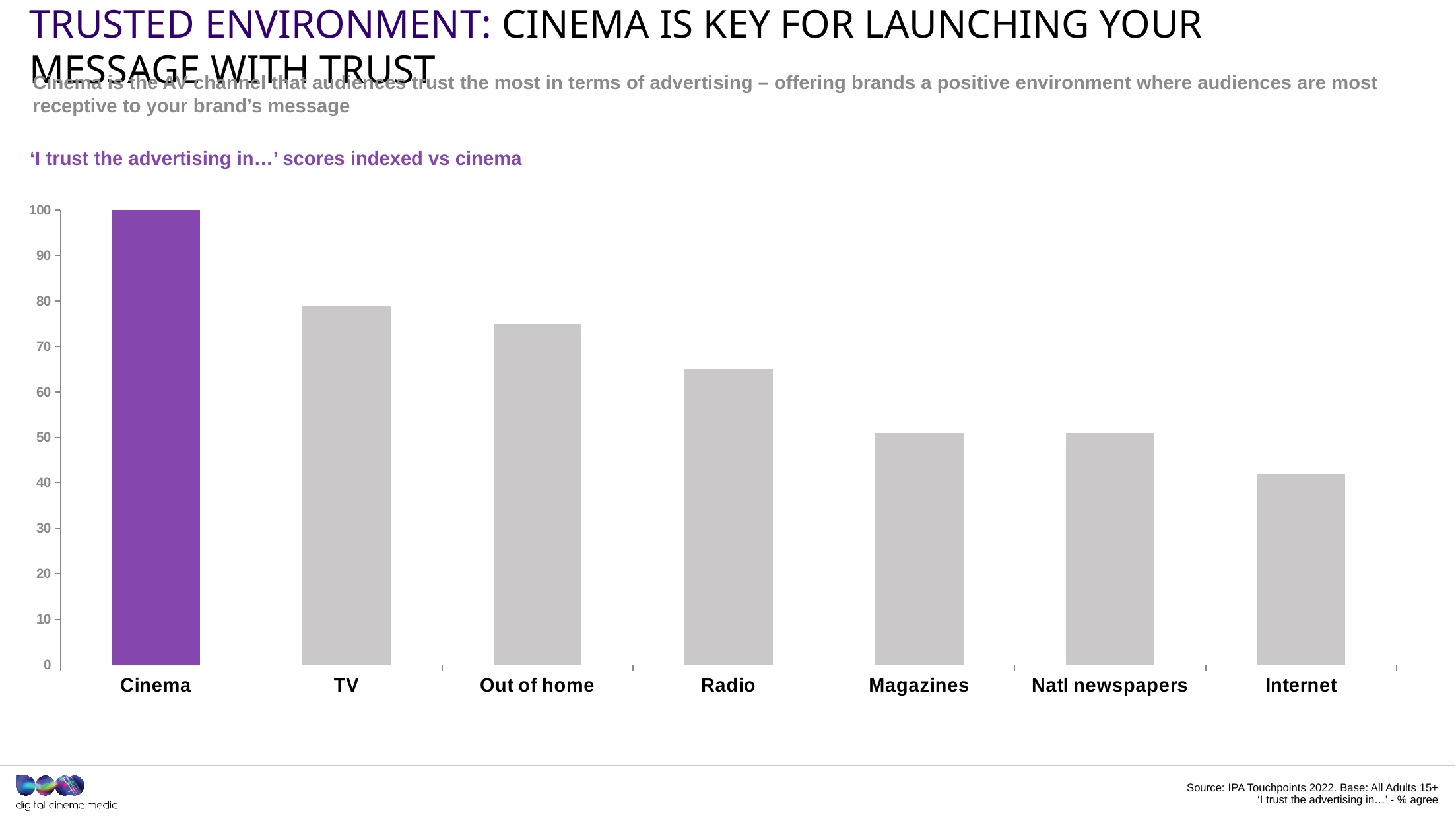
How many categories are plotted in the chart? 7 Do the values rise or fall moving from left to right along the x axis? Fall Which category has the highest value? Cinema Is the value for Internet greater or less than 50? less Is the value for Out of home greater or less than 70? greater Is the value for Radio greater or less than 60? greater What is the value for Cinema? 100 Which is larger, the value for TV or the value for Radio? TV What type of chart is shown on the slide? Bar chart Which category has the lowest value? Internet Which category's bar is coloured purple rather than grey? Cinema